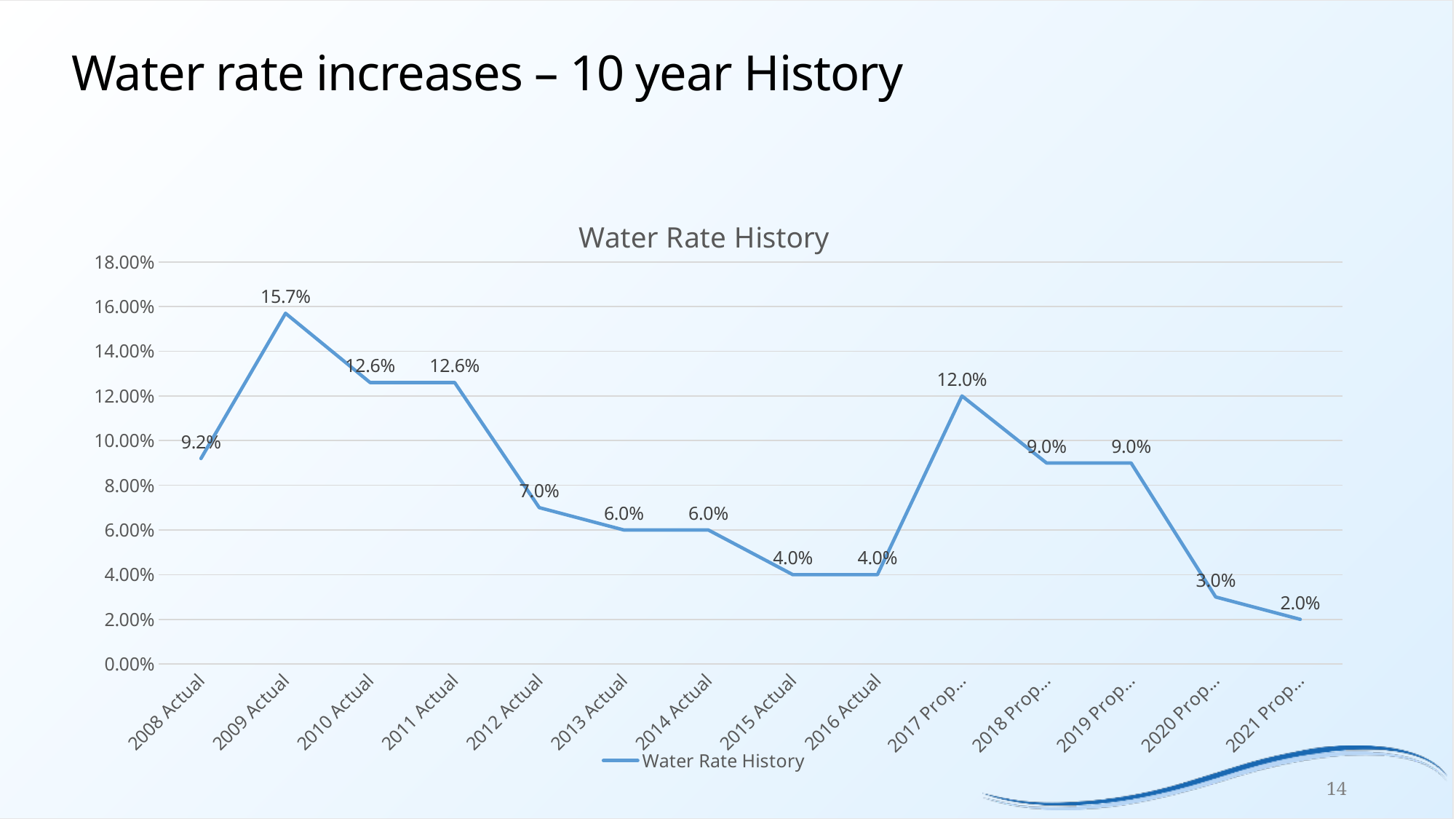
What is the value for 2012 Actual in the Water Rate History chart? 7.0% Which category has the highest value in the Water Rate History chart? 2009 Actual What is the value for 2009 Actual in the Water Rate History chart? 15.7% How many data points are plotted in the Water Rate History chart? 14 Which is larger in the Water Rate History chart: the value for 2010 Actual or the value for 2018 Prop...? 2010 Actual What is the value for the 2017 point (labelled '2017 Prop...') in the Water Rate History chart? 12.0% How many series does the legend of the Water Rate History chart list? 1 Do the values in the Water Rate History chart rise or fall from 2017 Prop... to 2021 Prop...? Fall What is the difference between the values for 2009 Actual and 2008 Actual in the Water Rate History chart? 6.5% What kind of chart is the Water Rate History chart? Line chart What is the value for the 2021 point (labelled '2021 Prop...') in the Water Rate History chart? 2.0% Which category has the lowest value in the Water Rate History chart? 2021 Prop...